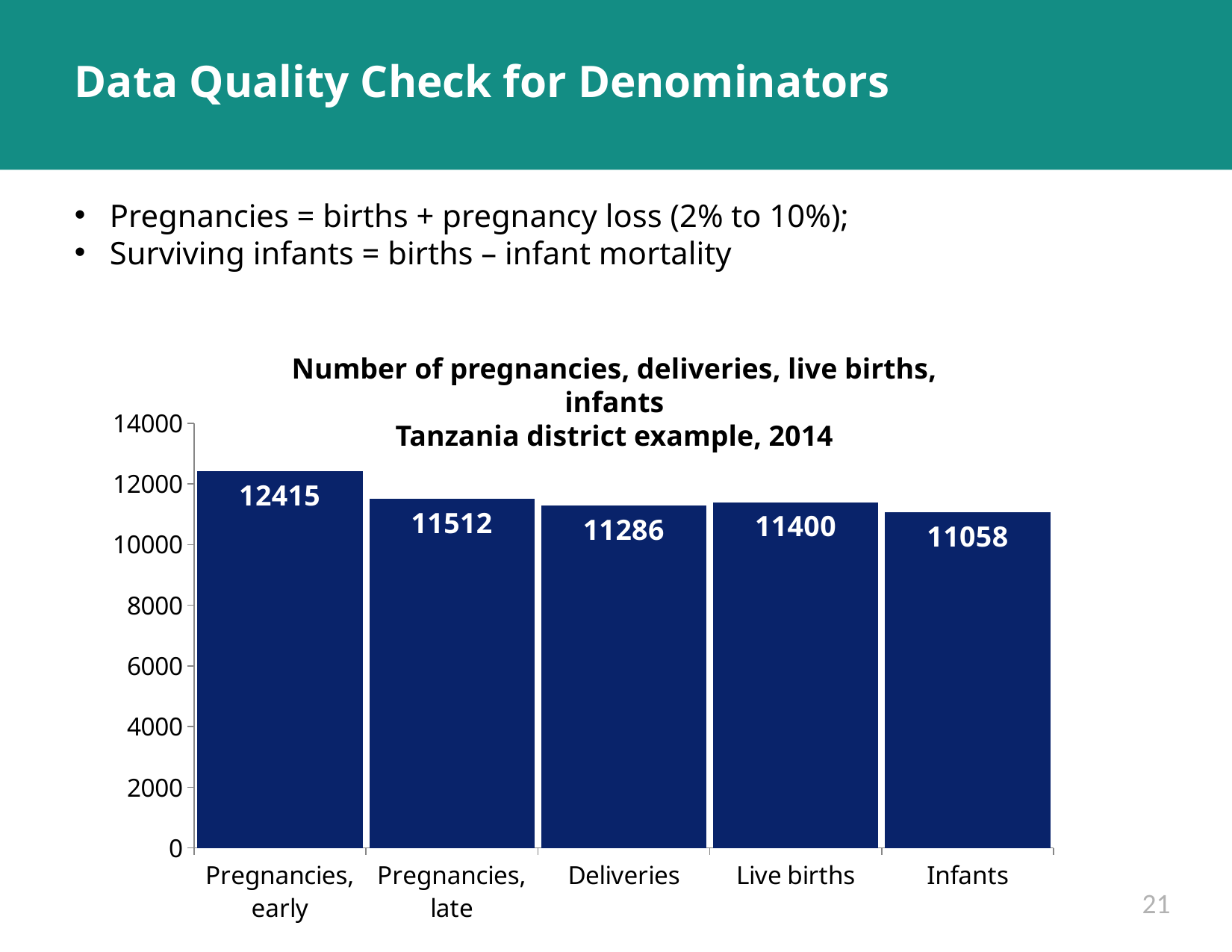
What is the value for Infants? 11058 Which category has the lowest value? Infants What is the value for Pregnancies, early? 12415 How many categories are shown on the x axis? 5 Which category has the highest value? Pregnancies, early Is the value for Pregnancies, early greater or less than 12000? greater What is the difference between Live births and Infants? 342 What is the value for Deliveries? 11286 What kind of chart is shown on the slide? bar chart What is the title of the chart? Number of pregnancies, deliveries, live births, infants Tanzania district example, 2014 What is the difference between Pregnancies, early and Pregnancies, late? 903 Which is larger, Deliveries or Live births? Live births